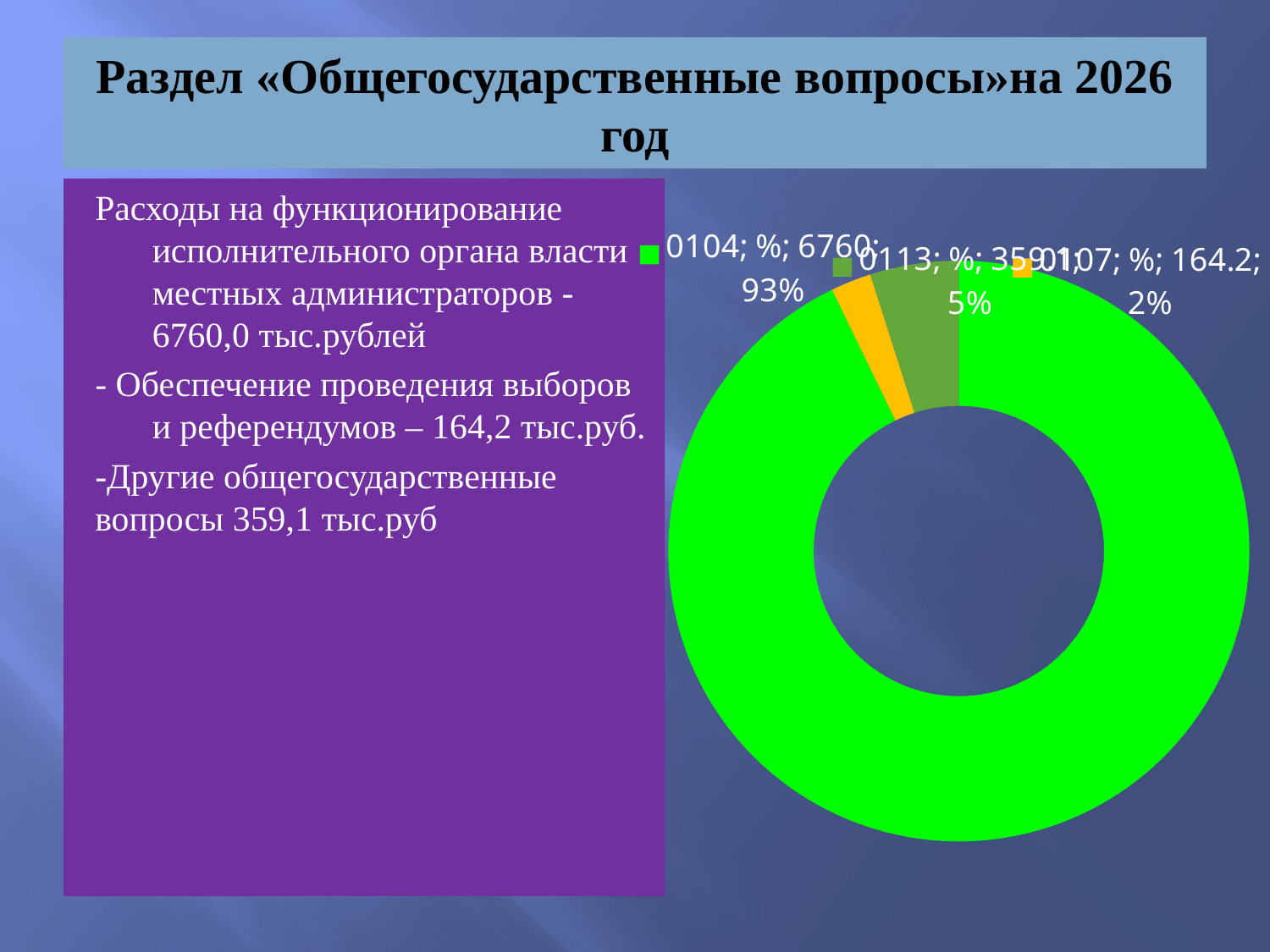
Which category has the smallest slice in the doughnut chart? 0107 Which category has the largest slice in the doughnut chart? 0104 Which slice is larger, 0113 or 0107? 0113 How many slices does the doughnut chart have? 3 What share of the doughnut chart does category 0104 represent? 93% What value is shown in the data label for category 0104? 6760 What share of the doughnut chart does category 0107 represent? 2% What kind of chart is shown on the slide? doughnut (pie) chart What share of the doughnut chart does category 0113 represent? 5% What colour is the largest slice (0104) in the doughnut chart? bright green What value is shown in the data label for category 0107? 164.2 What is the difference in percentage points between the 0104 slice and the 0113 slice? 88